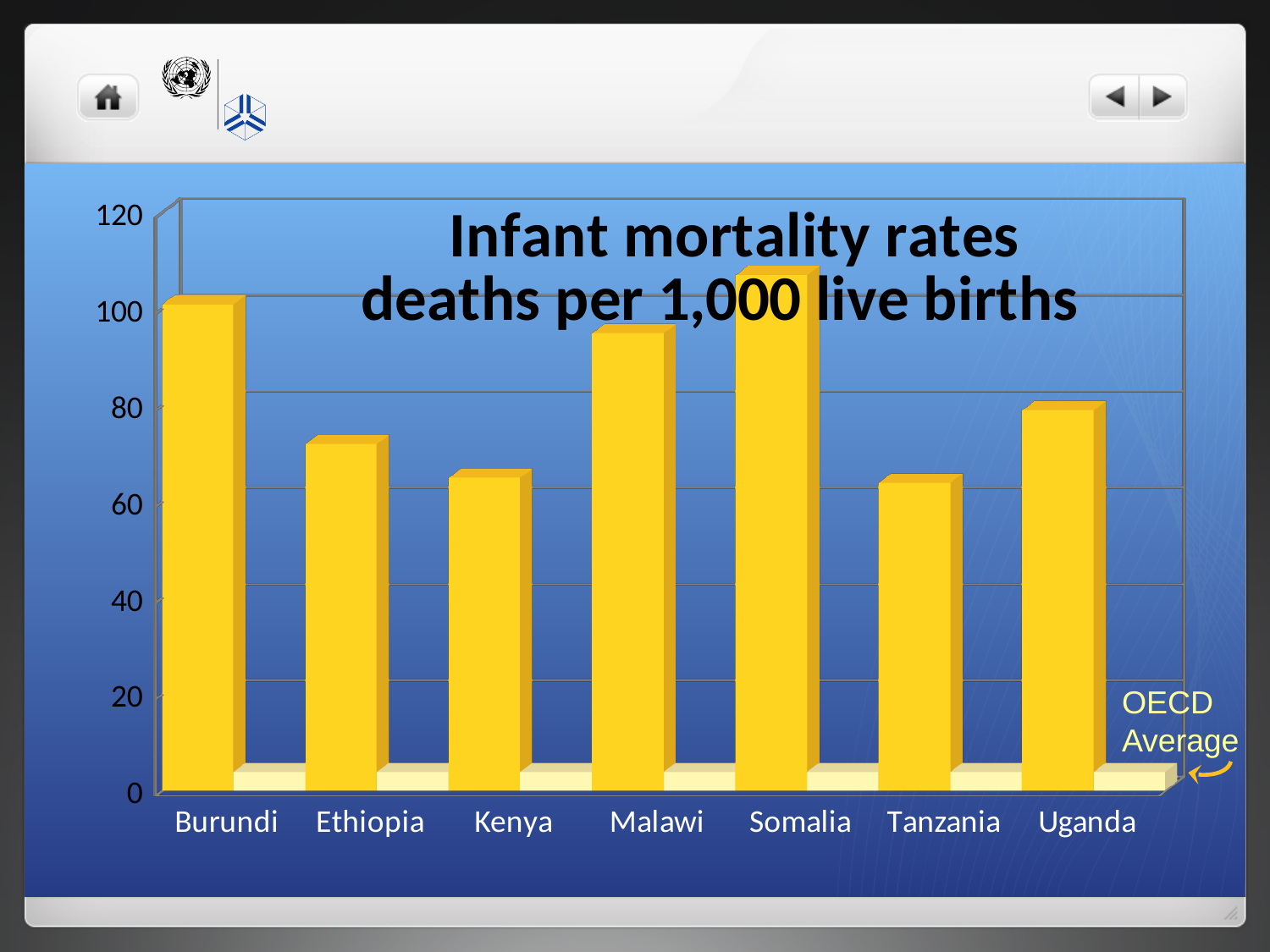
What does the label with the arrow at the bottom right of the chart refer to? OECD Average Which has a higher infant mortality rate, Malawi or Uganda? Malawi What is the title of the chart? Infant mortality rates deaths per 1,000 live births Is the value for Somalia greater or less than 100? greater Is the value for Kenya greater or less than 60? greater How many countries are shown on the x axis of the chart? 7 Is the value for Malawi greater or less than 80? greater Which country has the highest infant mortality rate in the chart? Somalia What kind of chart is shown on the slide? bar chart Which has a higher infant mortality rate, Burundi or Ethiopia? Burundi